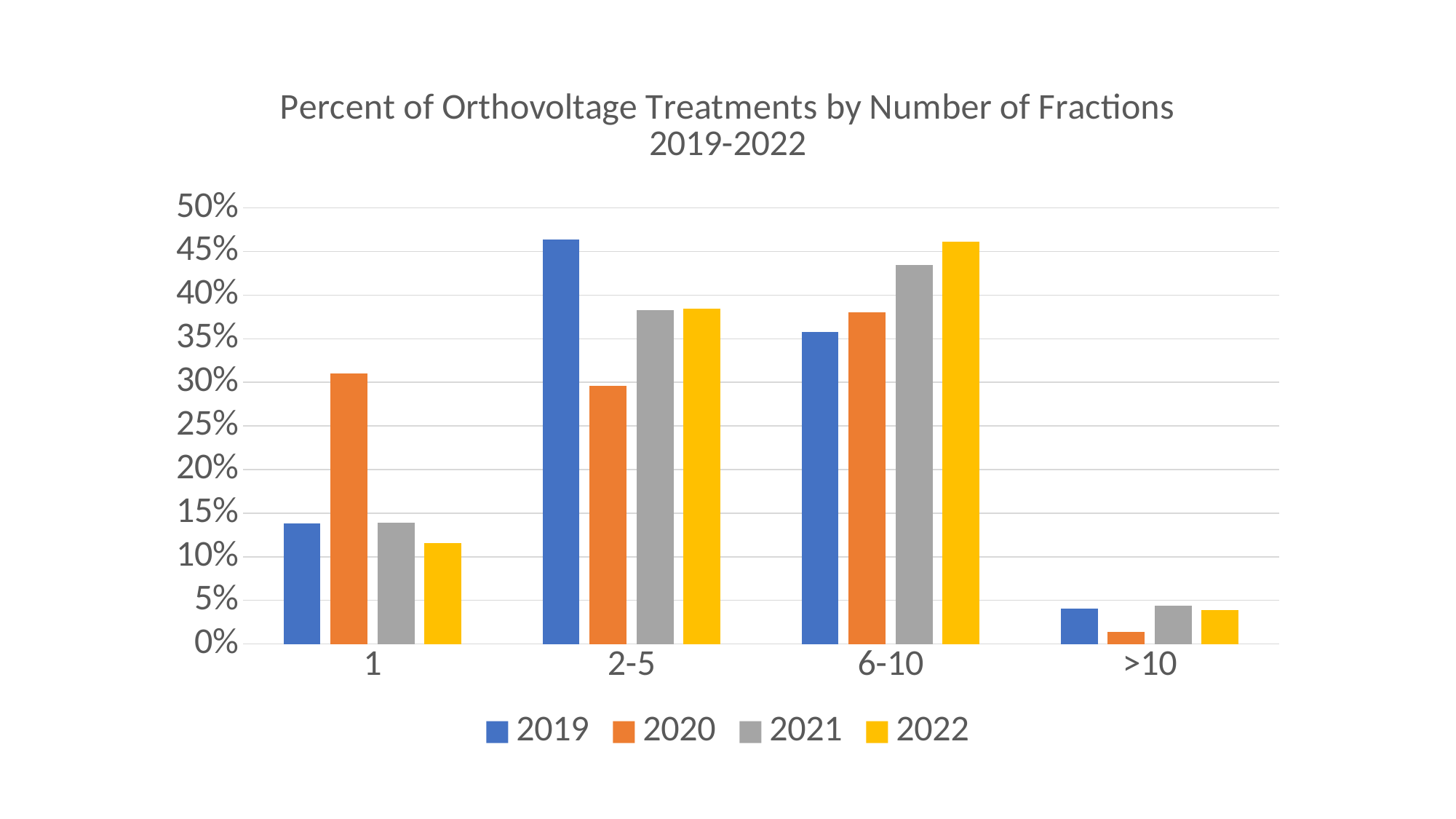
Is the value for 2020 in the 1 fraction category greater or less than 25%? greater In the 2-5 fractions category, which is larger: the value for 2019 or the value for 2021? 2019 Which year has the highest value in the 2-5 fractions category? 2019 How many fraction categories are shown on the x axis? 4 Is the value for 2020 in the 2-5 fractions category greater or less than 35%? less What kind of chart is shown on the slide? bar chart Is the value for 2019 in the 2-5 fractions category greater or less than 45%? greater Which year has the highest value in the 6-10 fractions category? 2022 What is the title of the chart? Percent of Orthovoltage Treatments by Number of Fractions 2019-2022 Which year has the lowest value in the >10 fractions category? 2020 How many series does the legend list? 4